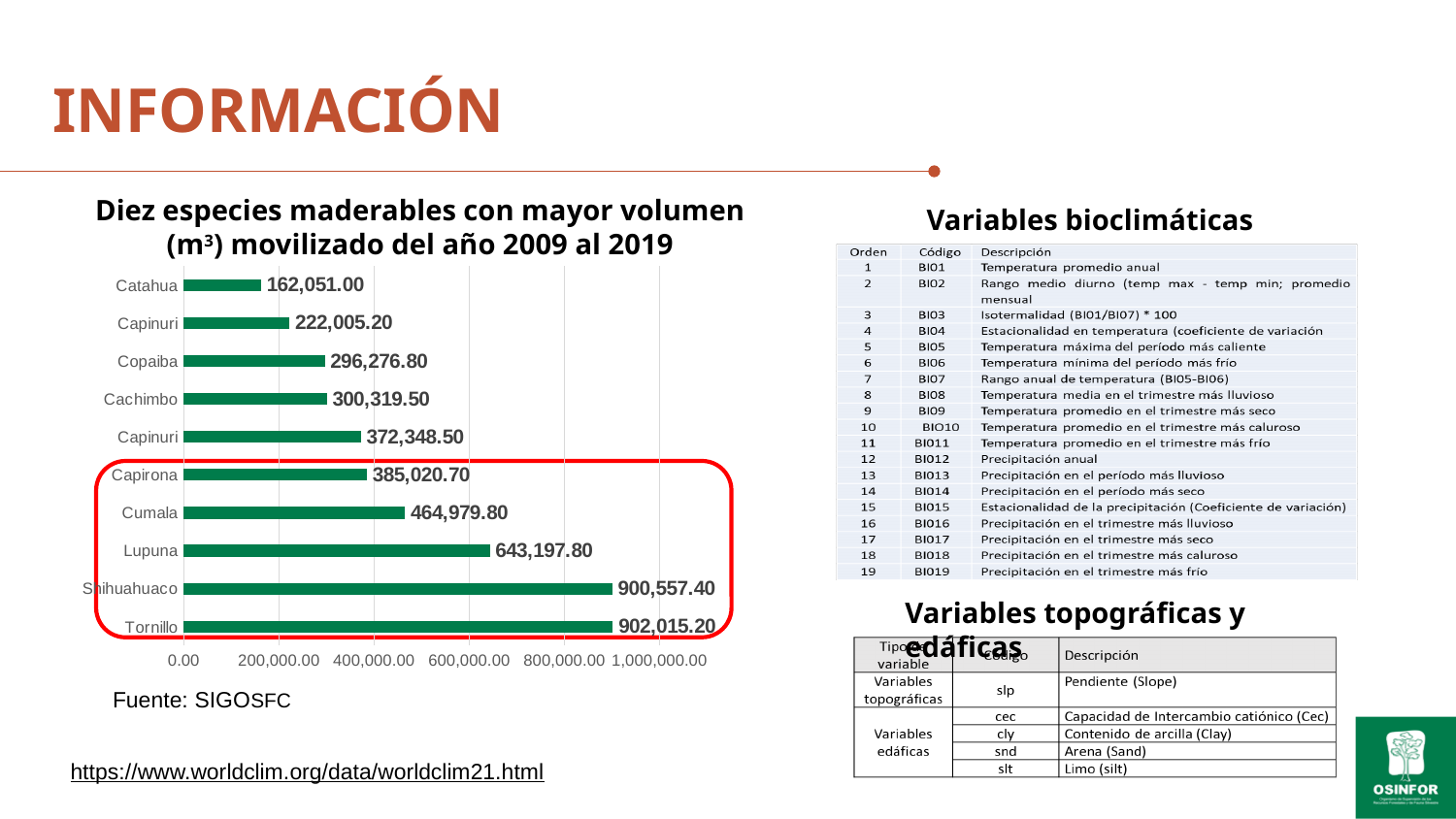
Which has a larger volume, Lupuna or Cumala? Lupuna What is the volume shown for Cumala? 464,979.80 What is the difference between the volumes of Lupuna and Cumala? 178,218.00 What is the volume shown for Lupuna? 643,197.80 How many species are shown in the chart? 10 What is the difference between the volumes of Tornillo and Catahua? 739,964.20 What source is cited below the chart? SIGOSFC Which species has the lowest volume in the chart? Catahua What kind of chart is used to show the species volumes? bar chart Is the value for Copaiba greater or less than 400,000.00? less What is the volume shown for Catahua? 162,051.00 What is the volume shown for Shihuahuaco? 900,557.40